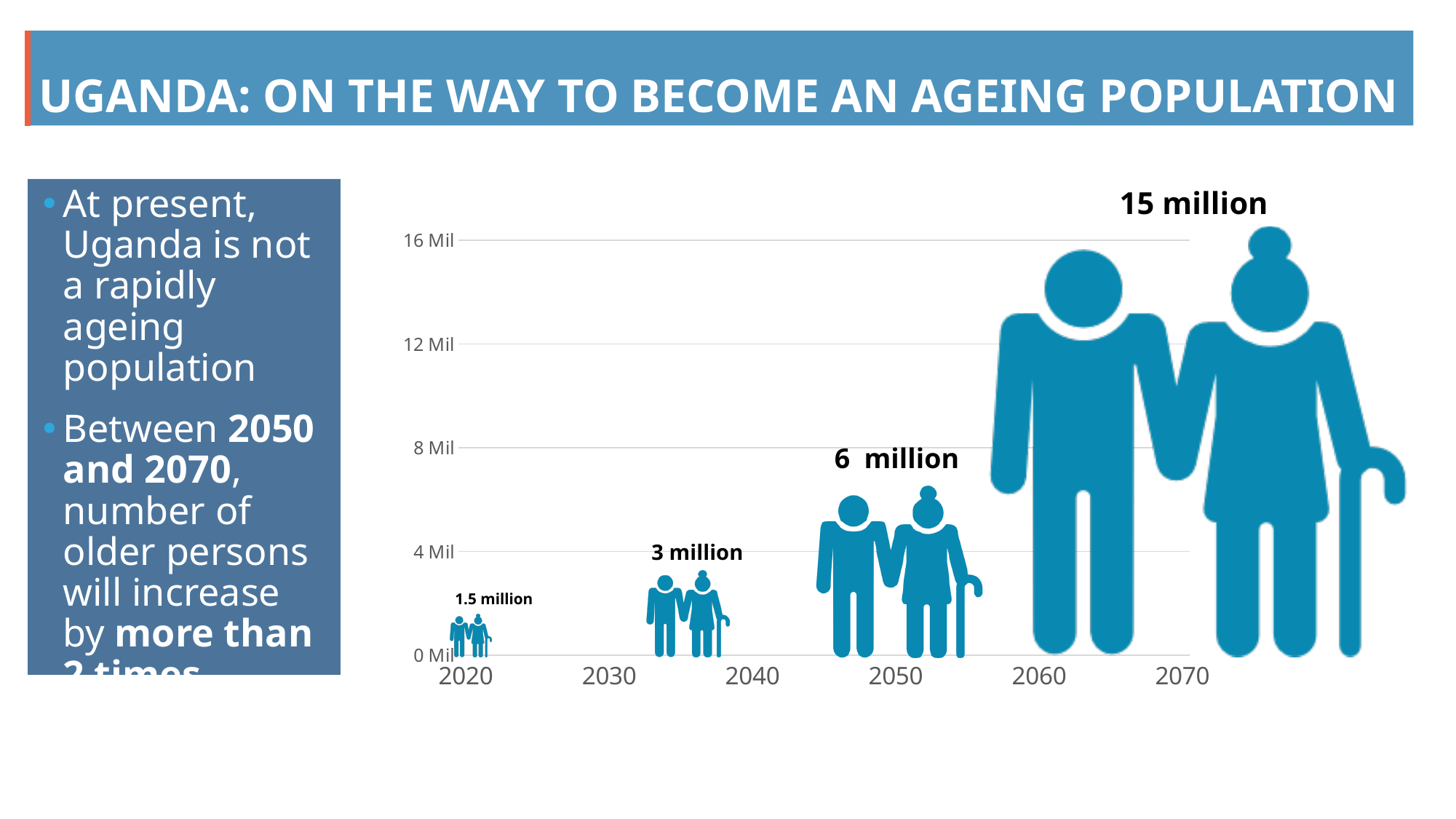
How many data points (labelled icon groups) are shown on the chart? 4 Is the largest value shown on the chart greater or less than 12 Mil? greater What is the highest tick label on the y axis? 16 Mil What range of years does the x axis cover? 2020 to 2070 What is the difference between the largest labelled value (15 million) and the value for 2050? 9 million Do the values rise or fall as the years increase along the x axis? rise What is the number of older persons shown for 2020? 1.5 million What is the largest value labelled on the chart? 15 million By how much does the value for 2050 exceed the value for 2020? 4.5 million What is the number of older persons shown for 2050? 6 million Which year has the larger value, 2020 or 2050? 2050 What is the smallest value labelled on the chart? 1.5 million